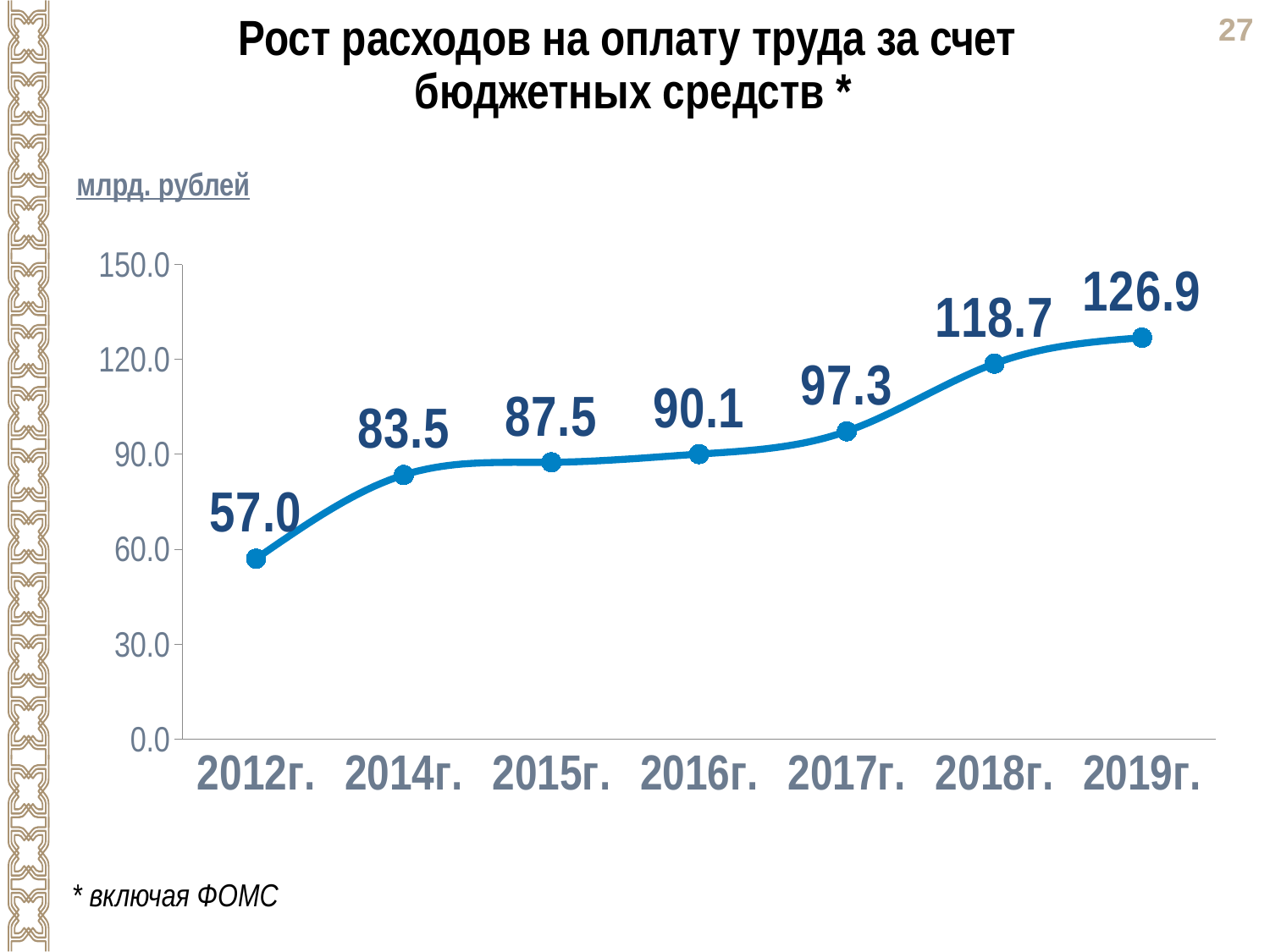
How many data points are plotted on the chart? 7 Which year has the highest value? 2019г. Do the values rise or fall from 2012г. to 2019г.? rise What is the difference between the values for 2018г. and 2017г.? 21.4 Which is larger, the value for 2015г. or the value for 2016г.? 2016г. Is the value for 2018г. greater or less than 90.0? greater Which year has the lowest value? 2012г. What is the value for 2012г.? 57.0 What is the difference between the values for 2019г. and 2012г.? 69.9 What is the value for 2019г.? 126.9 What kind of chart is shown on the slide? line chart What is the value for 2017г.? 97.3